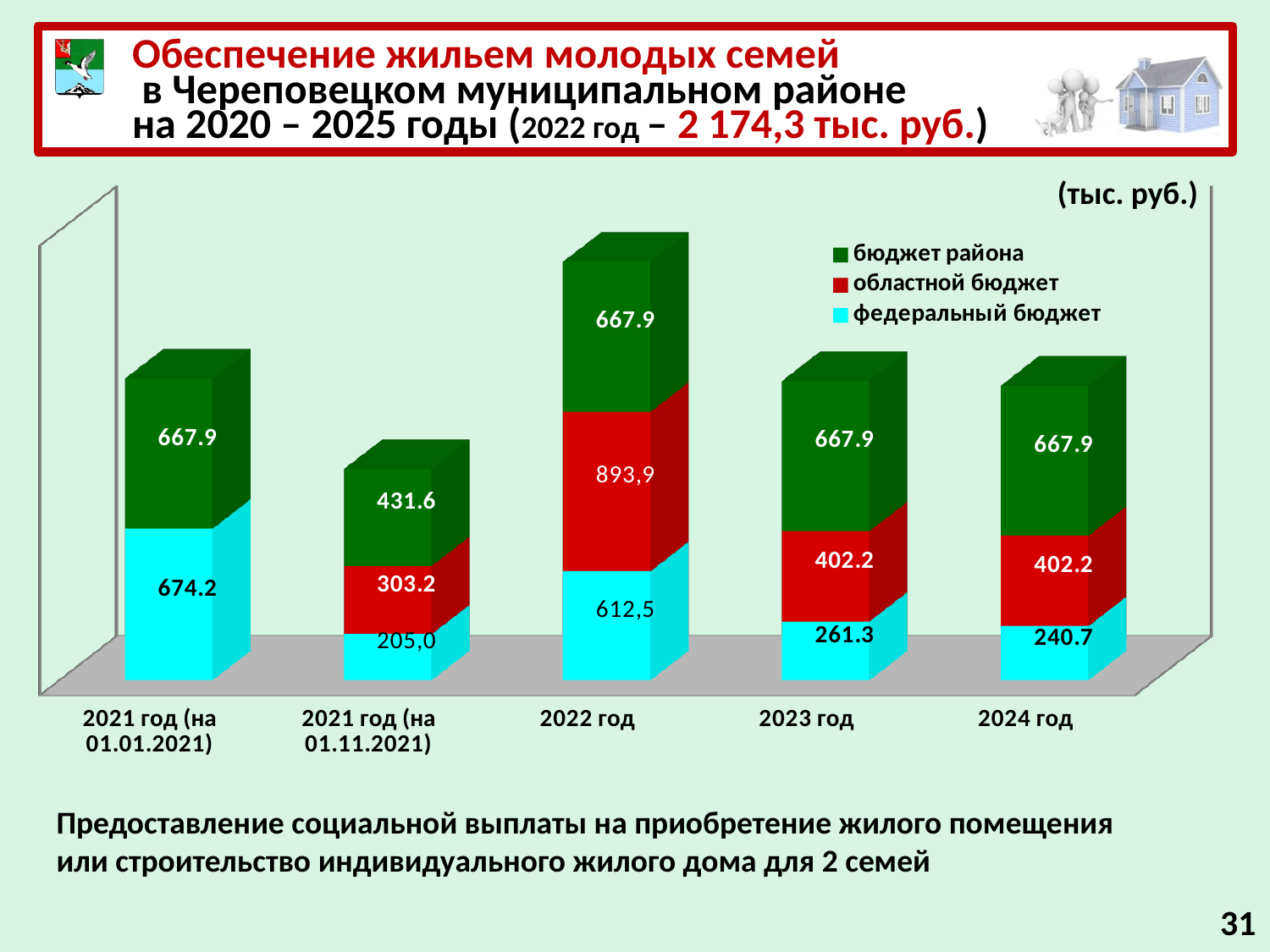
In which category is федеральный бюджет the lowest? 2021 год (на 01.11.2021) What type of chart is shown on the slide? stacked bar chart Which colour represents федеральный бюджет in the chart? cyan What is the value of федеральный бюджет for 2021 год (на 01.01.2021)? 674.2 How many categories are shown on the x axis? 5 What is the value of областной бюджет for 2022 год? 893,9 What is the value of бюджет района for 2021 год (на 01.11.2021)? 431.6 What is the difference between федеральный бюджет for 2023 год and 2024 год? 20.6 What is the total of the stacked bar for 2022 год? 2 174,3 In which category is областной бюджет the highest? 2022 год Which is larger: федеральный бюджет for 2022 год or for 2023 год? 2022 год How many series does the legend list? 3